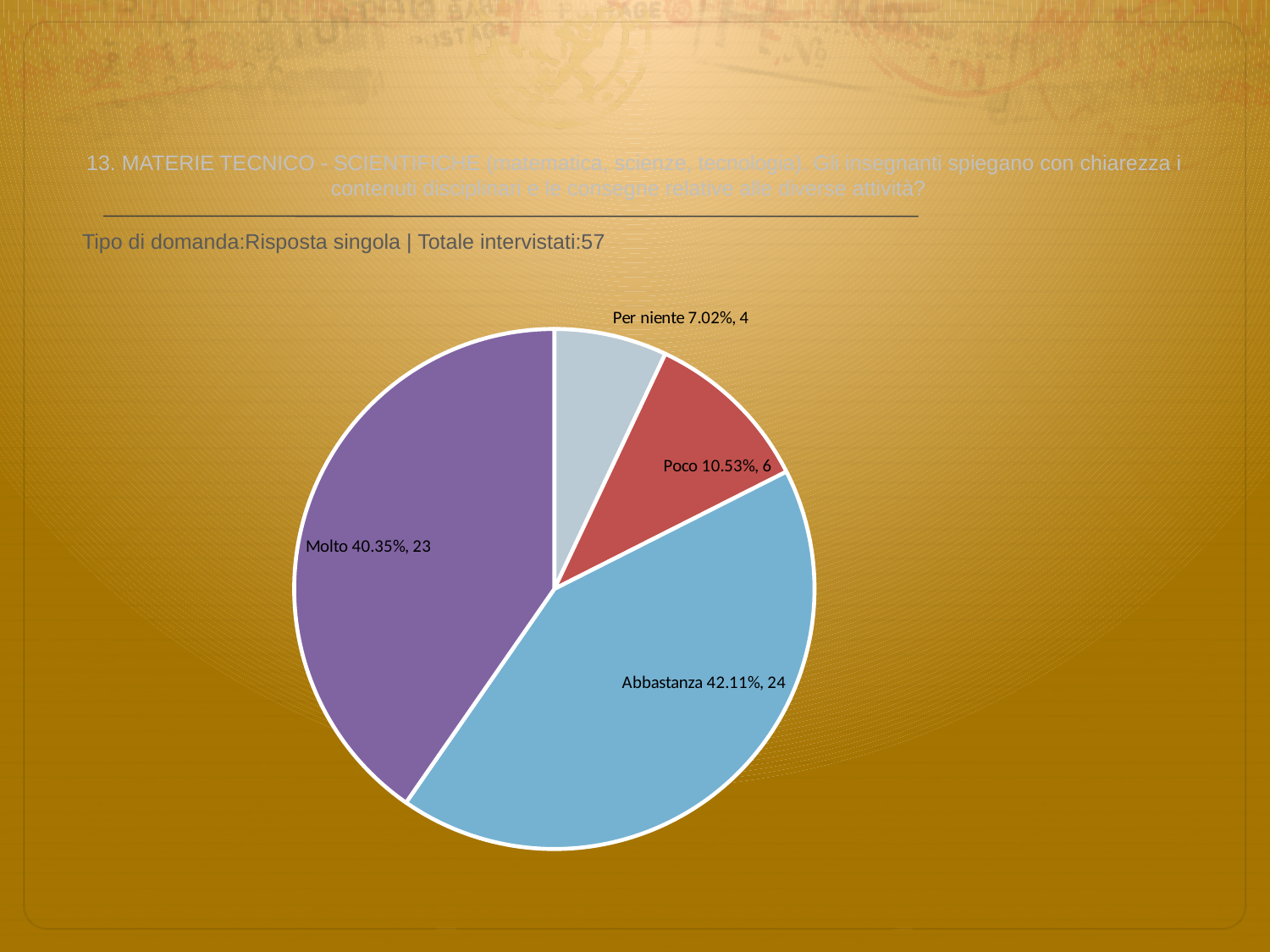
How many slices does the pie chart have? 4 Which has more respondents, Poco or Per niente? Poco Which category has the smallest slice? Per niente Which category has the largest slice? Abbastanza What percentage is shown for the Poco slice? 10.53% What percentage is shown for the Abbastanza slice? 42.11% How many respondents answered Molto? 23 What is the total number of respondents across all slices? 57 What is the difference in respondent count between Abbastanza and Molto? 1 What colour is the Molto slice? purple How many respondents answered Per niente? 4 What kind of chart is shown on the slide? pie chart